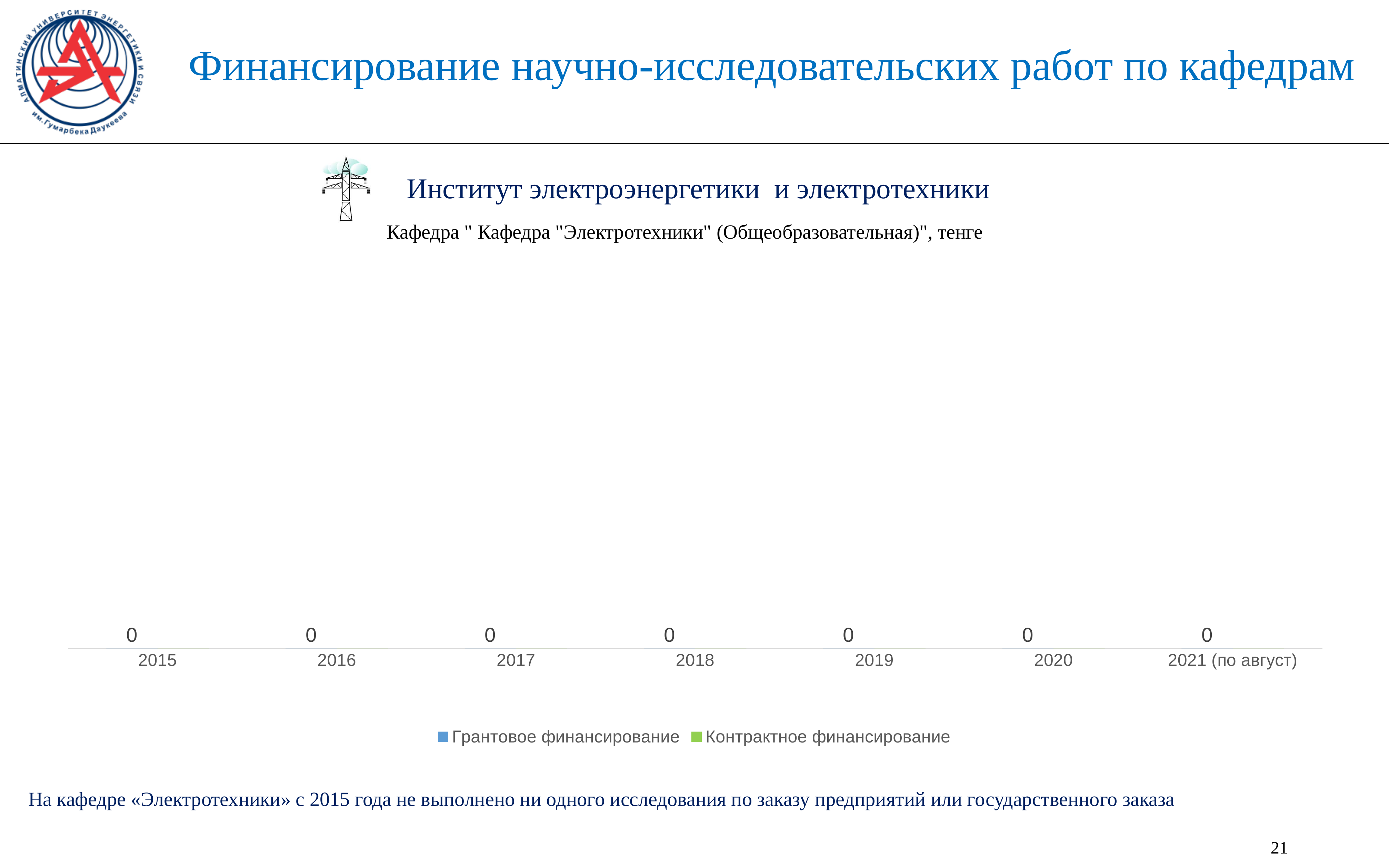
What value is shown for 2015 on the chart? 0 How many series does the chart's legend list? 2 How many year categories are shown on the x axis of the chart? 7 Is the value for 2017 greater than 0? no What are the two series named in the chart's legend? Грантовое финансирование, Контрактное финансирование Do the values on the chart rise, fall, or stay the same from 2015 to 2021 (по август)? stay the same What value is shown for 2018 on the chart? 0 What is the first year shown on the x axis of the chart? 2015 What value is shown for 2020 on the chart? 0 What value is shown for 2021 (по август) on the chart? 0